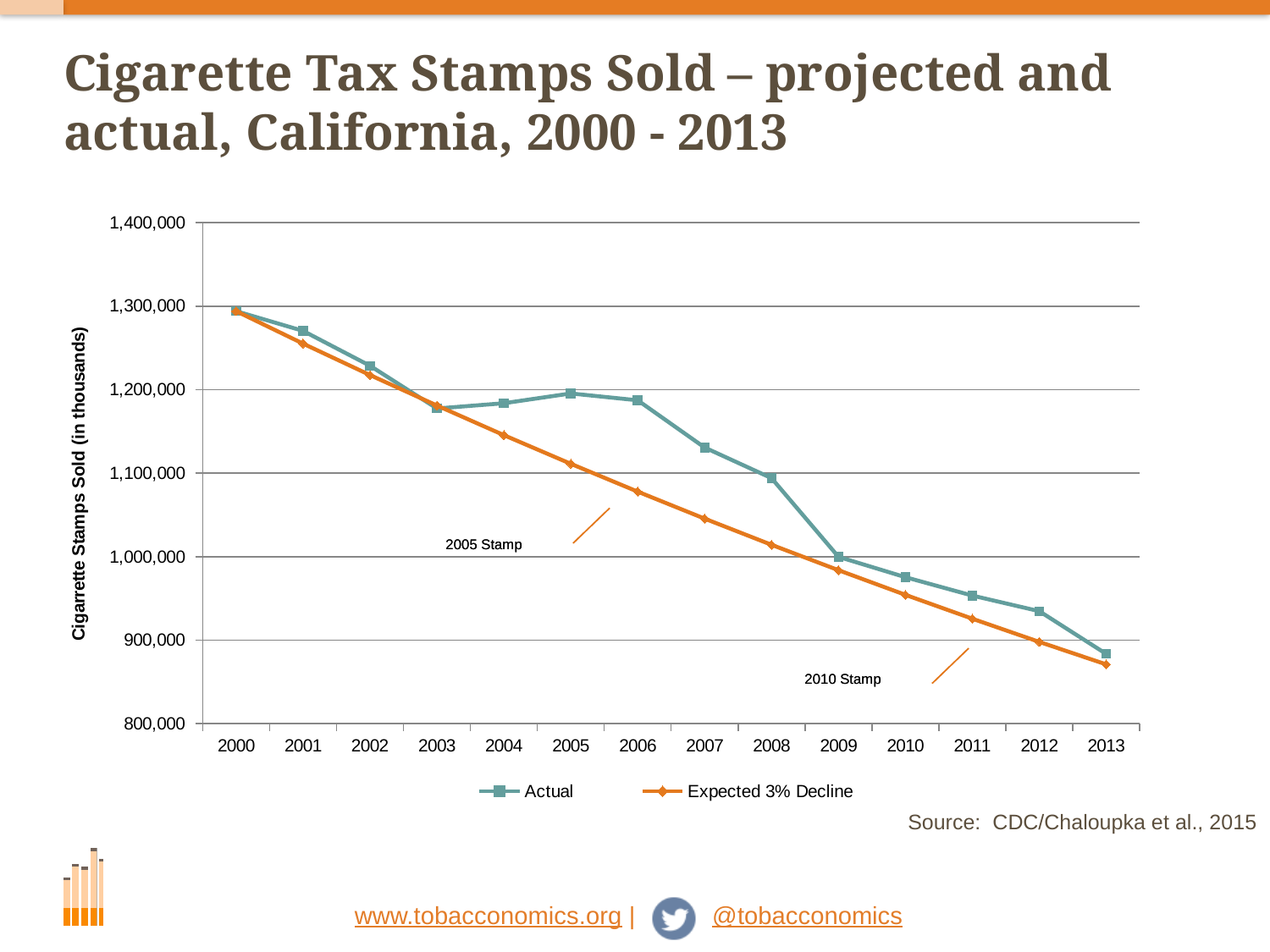
In which year is the Actual series at its lowest? 2013 What are the two series named in the legend? Actual and Expected 3% Decline Is the Expected 3% Decline value for 2007 greater or less than 1,000,000? greater How many series does the legend list? 2 What kind of chart is shown on the slide? Line chart Is the Actual value for 2005 greater or less than 1,100,000? greater In which year is the Actual series at its highest? 2000 How many years are plotted along the x axis? 14 In 2006, which series has the larger value, Actual or Expected 3% Decline? Actual Do the values of the Expected 3% Decline series rise or fall from 2000 to 2013? Fall Is the Actual value for 2013 greater or less than 900,000? less What is the title of the y axis? Cigarrette Stamps Sold (in thousands)